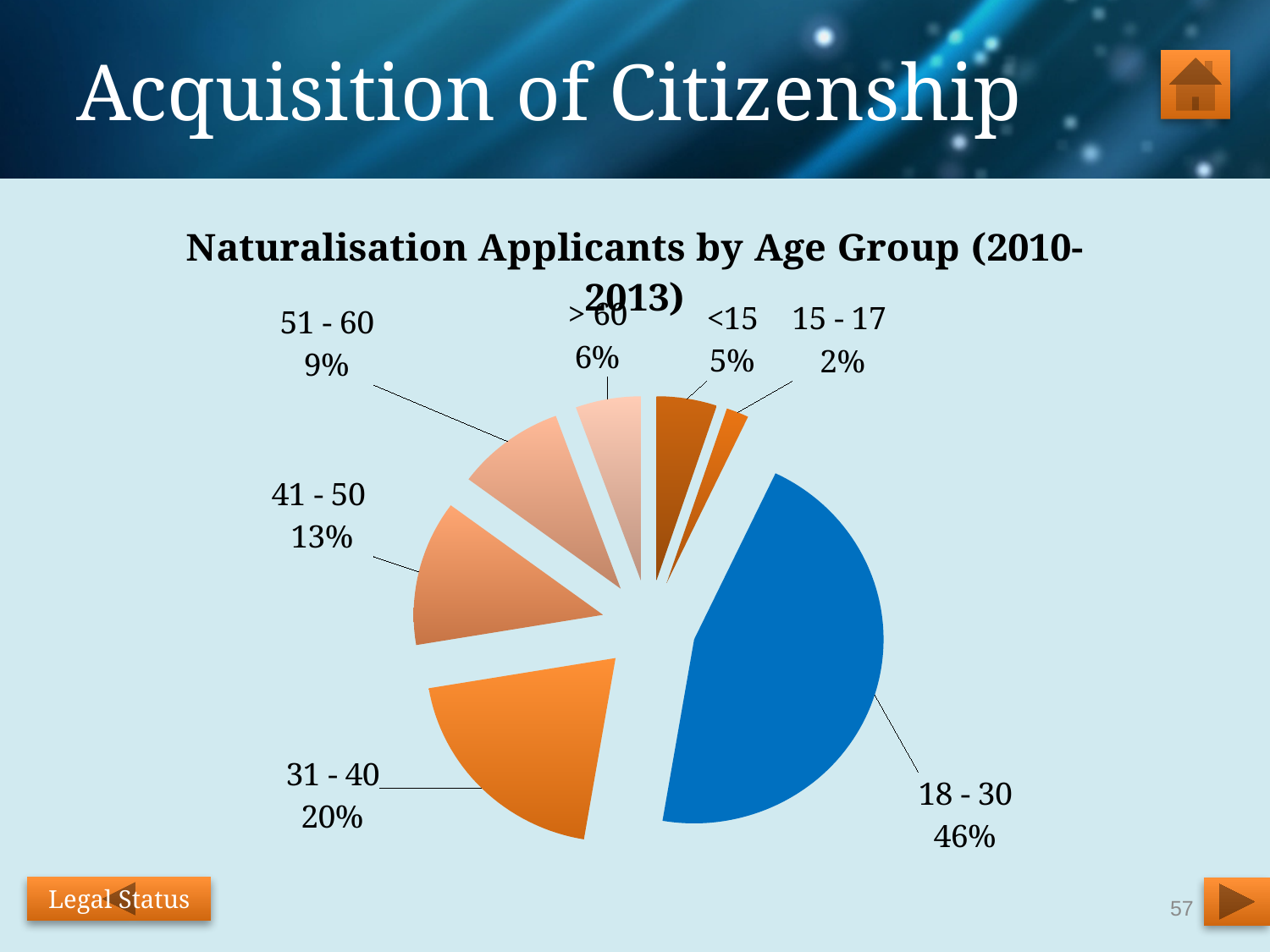
What share of naturalisation applicants are in the >60 age group? 6% Which age group has a larger share, 51 - 60 or <15? 51 - 60 What share of naturalisation applicants are in the 41 - 50 age group? 13% What is the difference in percentage points between the 18 - 30 and 31 - 40 age groups? 26 How many age groups are shown in the pie chart? 7 What is the title of the chart? Naturalisation Applicants by Age Group (2010-2013) Which age group has the smallest share of naturalisation applicants? 15 - 17 Which age group has the largest share of naturalisation applicants? 18 - 30 What share of naturalisation applicants are in the 18 - 30 age group? 46% What colour is the slice for the 18 - 30 age group? blue What type of chart is shown on the slide? pie chart